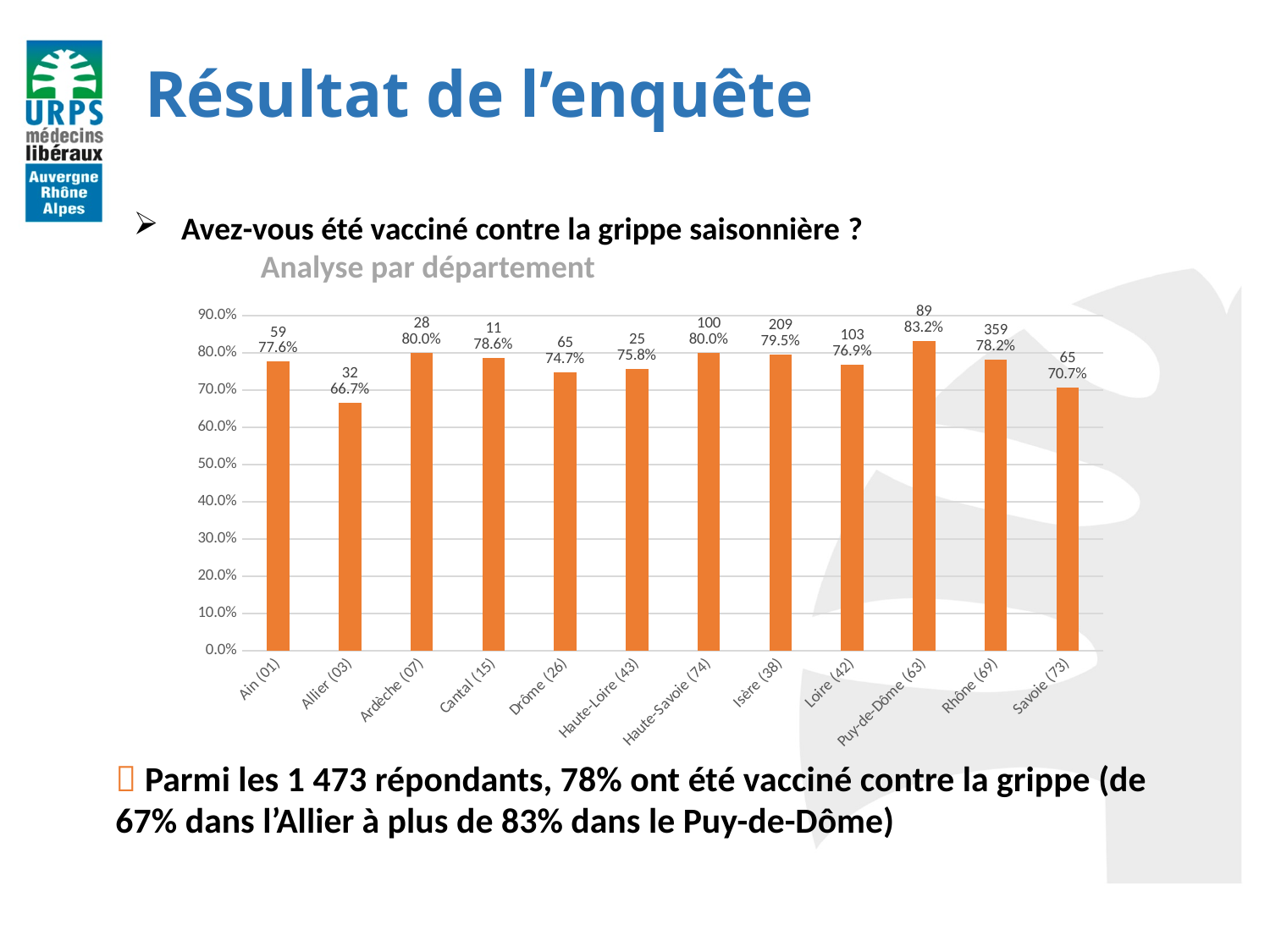
What is the title of the chart? Analyse par département What percentage is shown for Savoie (73)? 70.7% What count is printed above the bar for Rhône (69)? 359 What is the difference in percentage points between Puy-de-Dôme (63) and Allier (03)? 16.5 Which department has the lowest percentage? Allier (03) Which has a higher percentage, Drôme (26) or Isère (38)? Isère (38) What percentage is shown for Puy-de-Dôme (63)? 83.2% What count is printed above the bar for Cantal (15)? 11 What percentage is shown for Allier (03)? 66.7% Which department has the highest percentage? Puy-de-Dôme (63) What type of chart is used? Bar chart How many departments are shown on the x axis? 12